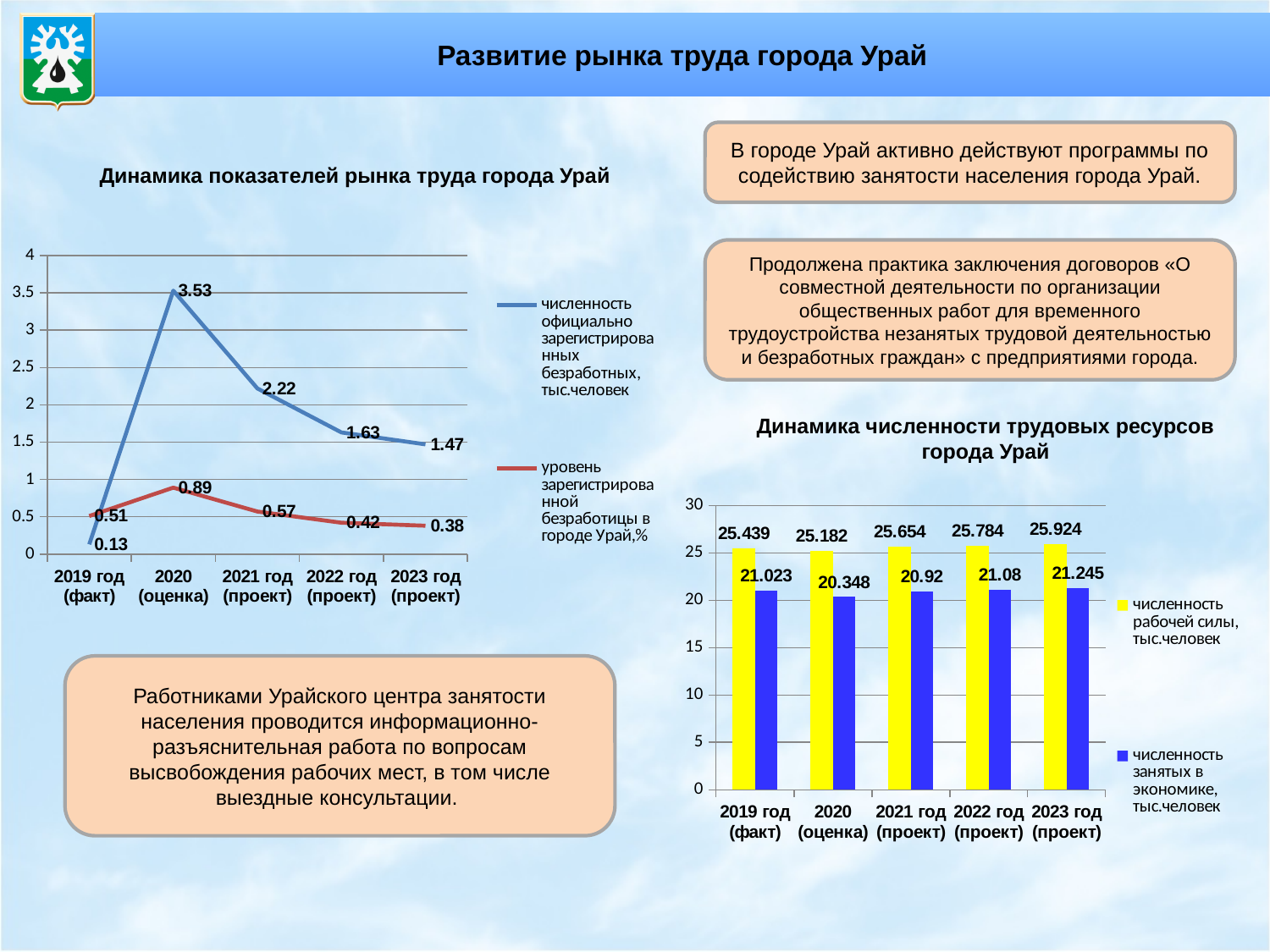
On the chart 'Динамика численности трудовых ресурсов города Урай', in which year is the labour force ('численность рабочей силы') the highest? 2023 год (проект) On the chart 'Динамика численности трудовых ресурсов города Урай', what is the value of 'численность рабочей силы, тыс.человек' for 2022 год (проект)? 25.784 On the chart 'Динамика показателей рынка труда города Урай', what is the value of 'численность официально зарегистрированных безработных, тыс.человек' for 2020 (оценка)? 3.53 How many year categories are shown on the x axis of the chart 'Динамика численности трудовых ресурсов города Урай'? 5 On the chart 'Динамика численности трудовых ресурсов города Урай', which is larger: the number employed in the economy in 2019 год (факт) or in 2020 (оценка)? 2019 год (факт) On the chart 'Динамика численности трудовых ресурсов города Урай', what is the value of 'численность занятых в экономике, тыс.человек' for 2020 (оценка)? 20.348 On the chart 'Динамика показателей рынка труда города Урай', what is the difference between the number of registered unemployed in 2020 (оценка) and in 2021 год (проект)? 1.31 How many series does the legend of the chart 'Динамика численности трудовых ресурсов города Урай' list? 2 On the chart 'Динамика показателей рынка труда города Урай', in which year is the number of registered unemployed the lowest? 2019 год (факт) What type of chart is 'Динамика показателей рынка труда города Урай'? line chart On the chart 'Динамика показателей рынка труда города Урай', does the registered unemployment rate rise or fall from 2020 (оценка) to 2023 год (проект)? fall On the chart 'Динамика показателей рынка труда города Урай', what is the value of 'уровень зарегистрированной безработицы в городе Урай,%' for 2023 год (проект)? 0.38